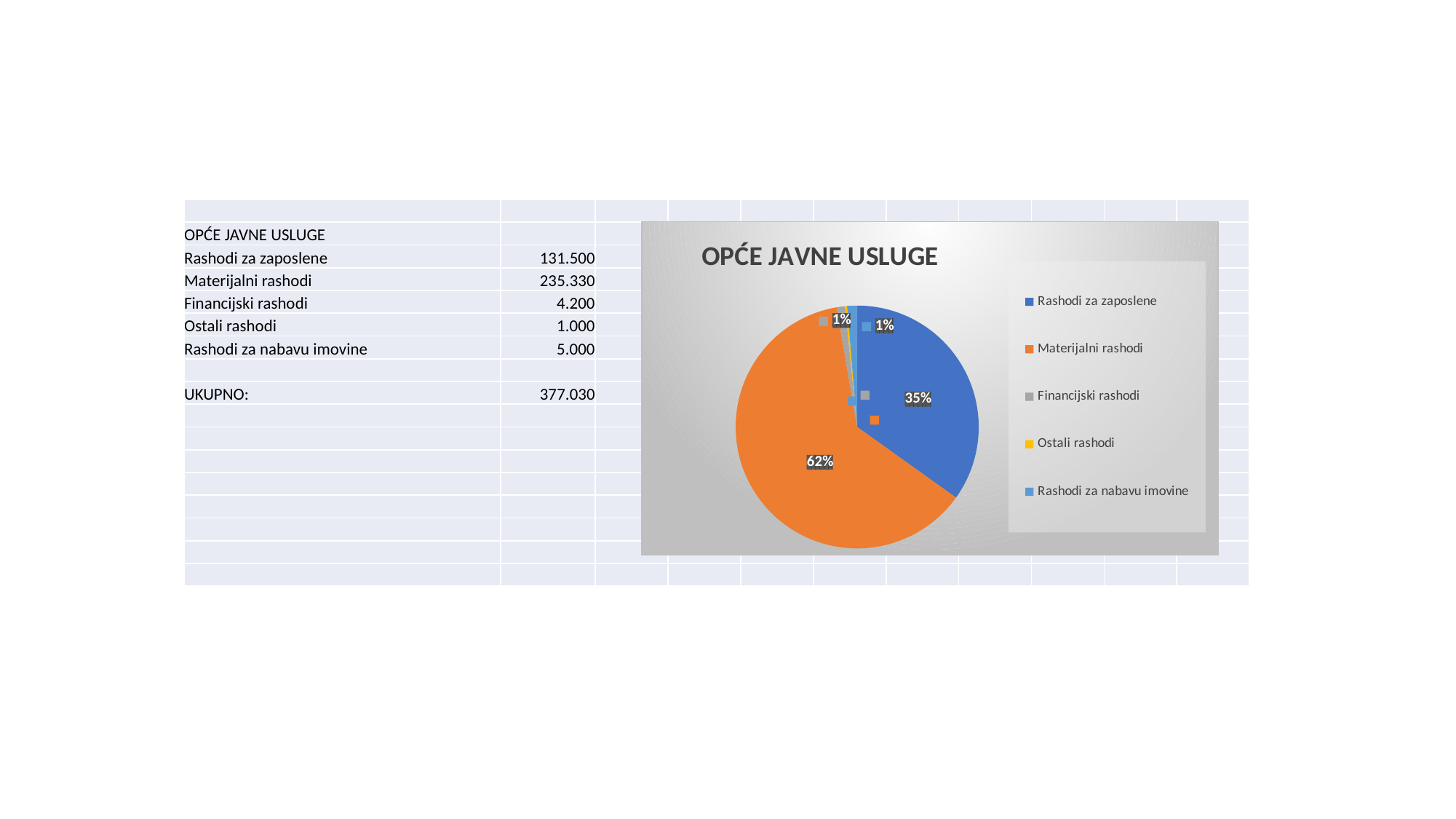
Which colour represents Ostali rashodi in the legend? yellow What is the title of the chart? OPĆE JAVNE USLUGE What share of the pie does Financijski rashodi take? 1% Is the share for Rashodi za zaposlene greater or less than 50%? less What share of the pie does Rashodi za zaposlene take? 35% What kind of chart is shown on the slide? pie chart Which category has the largest slice of the pie? Materijalni rashodi What share of the pie does Rashodi za nabavu imovine take? 1% Which is larger, the slice for Rashodi za zaposlene or the slice for Materijalni rashodi? Materijalni rashodi What is the difference in percentage points between the Materijalni rashodi slice and the Rashodi za zaposlene slice? 27 How many categories does the legend of the pie chart list? 5